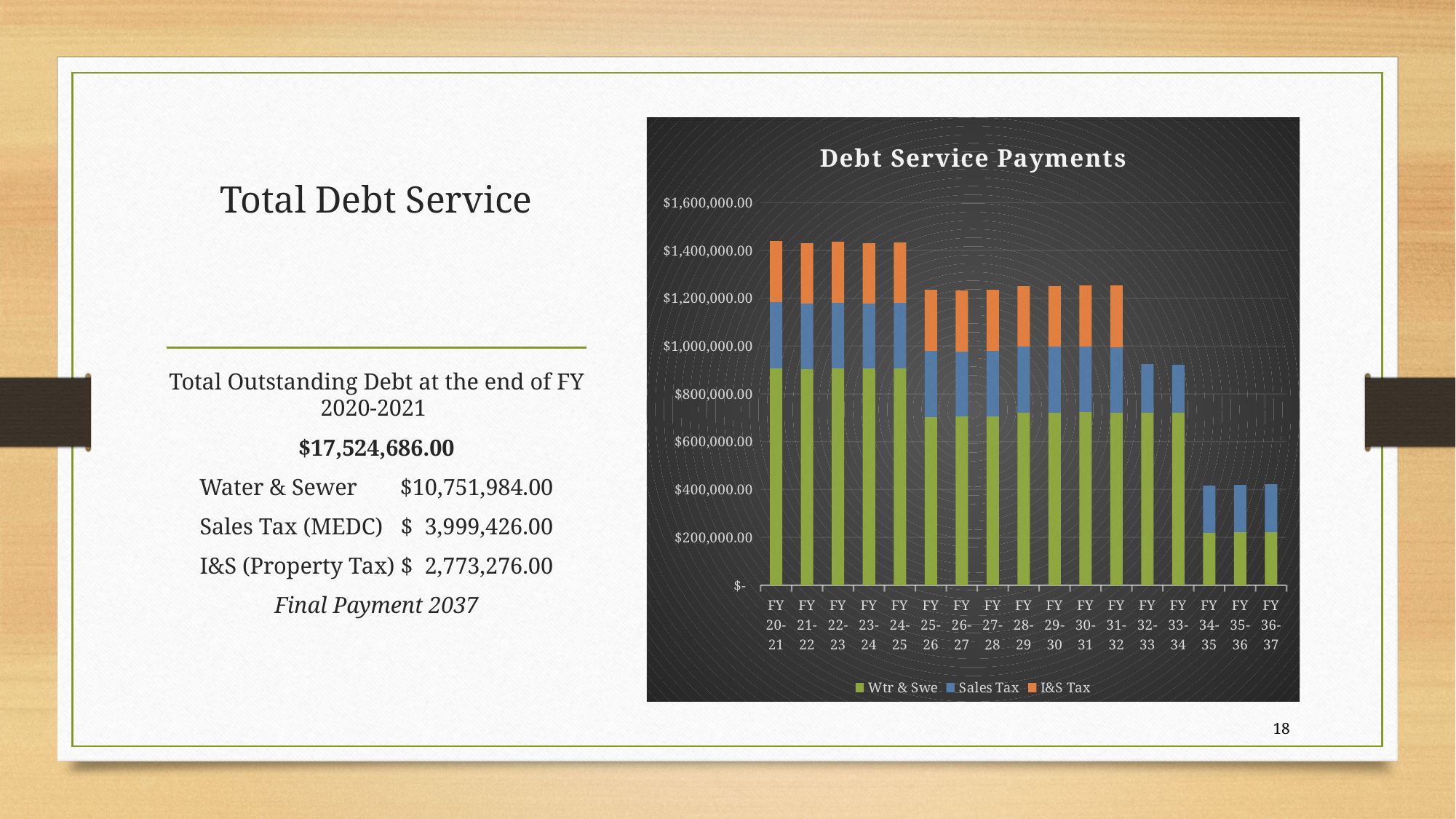
How many series does the chart legend list? 3 How many fiscal years in the chart include an I&S Tax segment? 12 Which has a larger total debt service payment, FY 20-21 or FY 36-37? FY 20-21 Is the total debt service payment for FY 36-37 greater or less than $600,000.00? less Is the total debt service payment for FY 20-21 greater or less than $1,200,000.00? greater How many fiscal years are plotted on the x axis of the chart? 17 What is the title of the chart? Debt Service Payments Is the Wtr & Swe value for FY 34-35 greater or less than $400,000.00? less Do the total debt service payments generally rise or fall from FY 20-21 to FY 36-37? fall What kind of chart is shown on the slide? Stacked bar chart Which series is shown in orange in the chart? I&S Tax